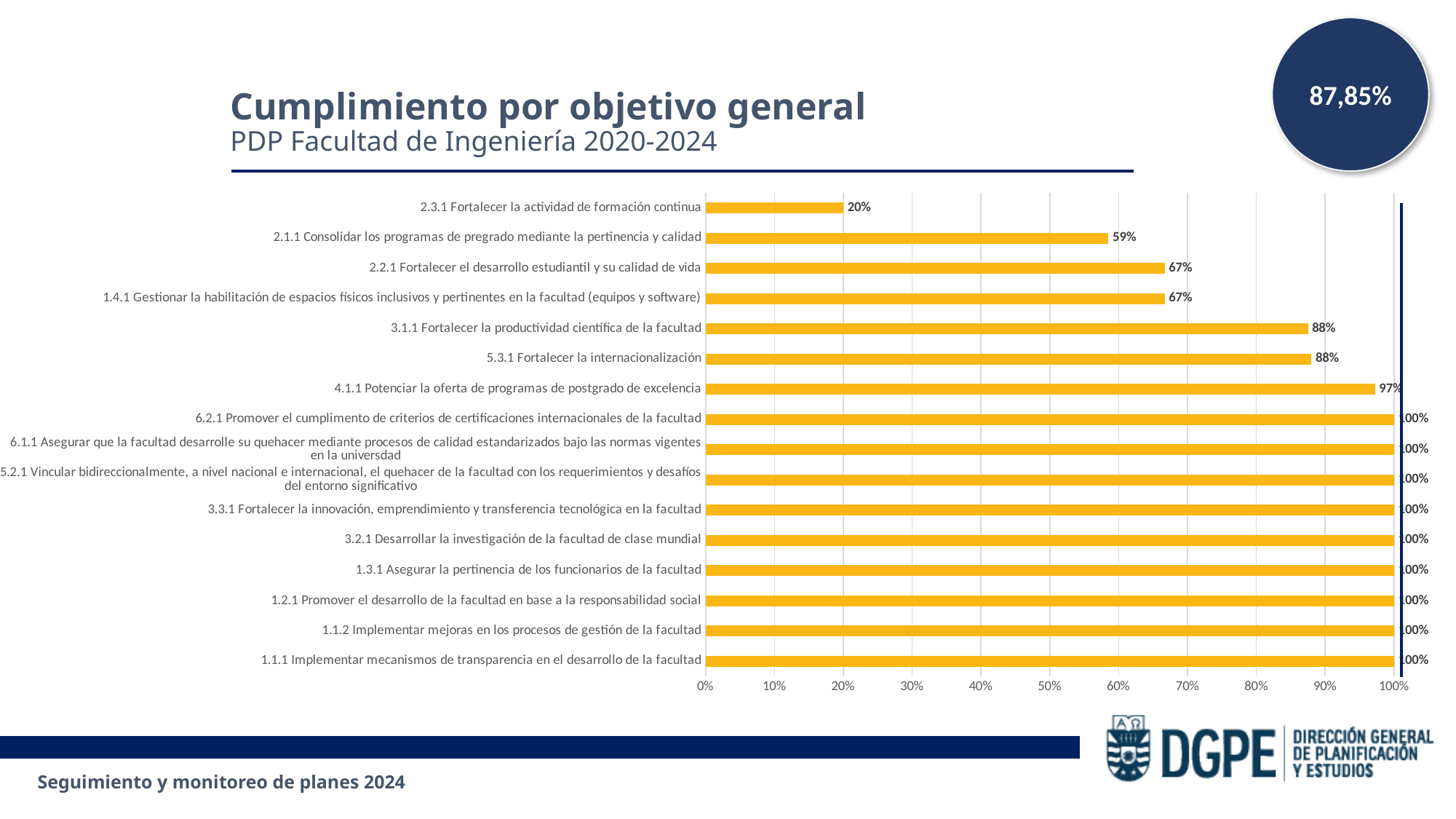
What is the value for 2.1.1 Consolidar los programas de pregrado mediante la pertinencia y calidad? 59% What overall percentage is shown in the circle at the top right of the slide? 87,85% What is the difference between the values for 2.1.1 Consolidar los programas de pregrado and 2.3.1 Fortalecer la actividad de formación continua? 39 percentage points Which is larger, the value for 2.2.1 Fortalecer el desarrollo estudiantil or the value for 3.1.1 Fortalecer la productividad científica? 3.1.1 Fortalecer la productividad científica What is the value for 5.3.1 Fortalecer la internacionalización? 88% Which objective has the lowest value in the chart? 2.3.1 Fortalecer la actividad de formación continua What is the value for 2.3.1 Fortalecer la actividad de formación continua? 20% How many objectives are shown in the chart? 16 What is the difference between the values for 4.1.1 Potenciar la oferta de programas de postgrado de excelencia and 3.1.1 Fortalecer la productividad científica de la facultad? 9 percentage points What kind of chart is shown on the slide? Bar chart How many objectives have a value of 100%? 9 What is the value for 4.1.1 Potenciar la oferta de programas de postgrado de excelencia? 97%